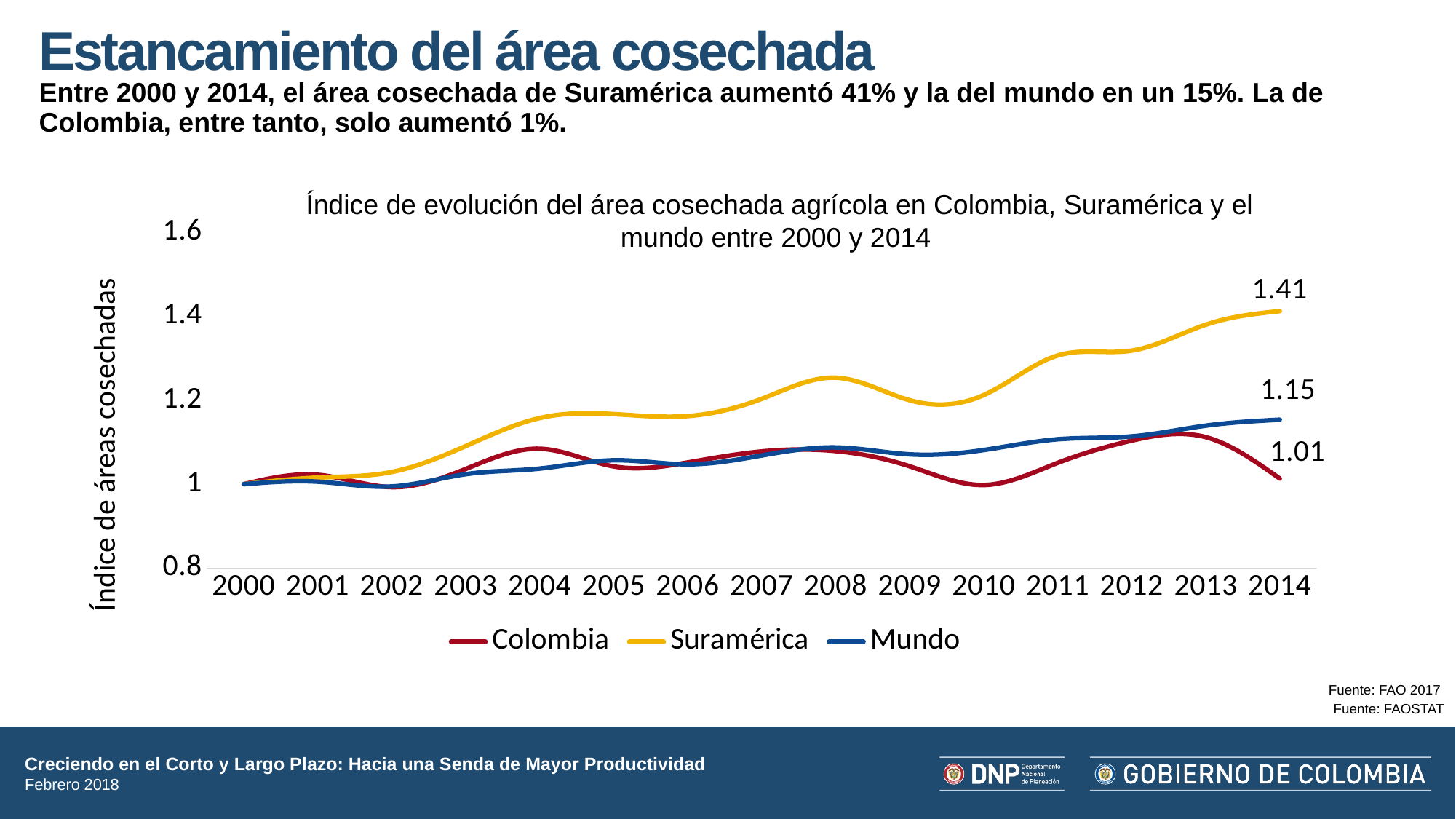
Is the value for Suramérica in 2008 greater or less than 1.2? greater How many series does the legend list? 3 What is the value for Colombia in 2014? 1.01 What kind of chart is shown on the slide? line chart Which series has the highest value in 2014? Suramérica Which series has the lowest value in 2014? Colombia What is the difference between the Mundo and Colombia values in 2014? 0.14 What is the value for Mundo in 2014? 1.15 Does the Suramérica series generally rise or fall from 2000 to 2014? rise In 2014, which is larger: the value for Suramérica or the value for Colombia? Suramérica What is the difference between the Suramérica and Mundo values in 2014? 0.26 What is the value for Suramérica in 2014? 1.41